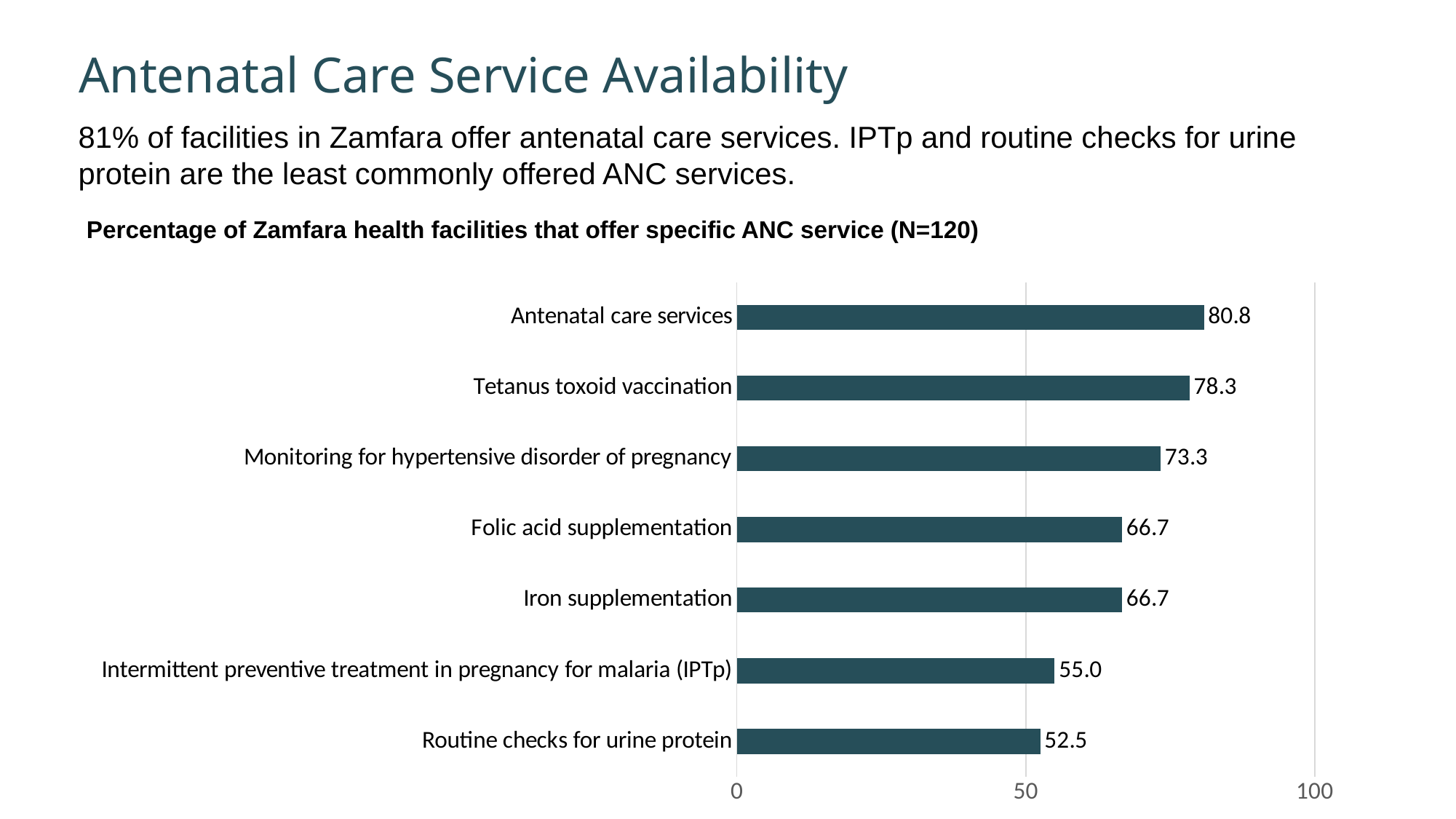
Which category has the lowest value? Routine checks for urine protein What is the value for Intermittent preventive treatment in pregnancy for malaria (IPTp)? 55.0 Which is larger, the value for Tetanus toxoid vaccination or the value for Iron supplementation? Tetanus toxoid vaccination Is the value for Folic acid supplementation greater or less than 50? greater What is the difference between the values for Antenatal care services and Routine checks for urine protein? 28.3 What is the value for Routine checks for urine protein? 52.5 What percentage of Zamfara health facilities offer tetanus toxoid vaccination? 78.3 How many categories are shown in the chart? 7 What kind of chart is shown on the slide? Bar chart Which category has the highest value? Antenatal care services What is the title of the chart? Percentage of Zamfara health facilities that offer specific ANC service (N=120) What is the difference between the values for Monitoring for hypertensive disorder of pregnancy and Folic acid supplementation? 6.6